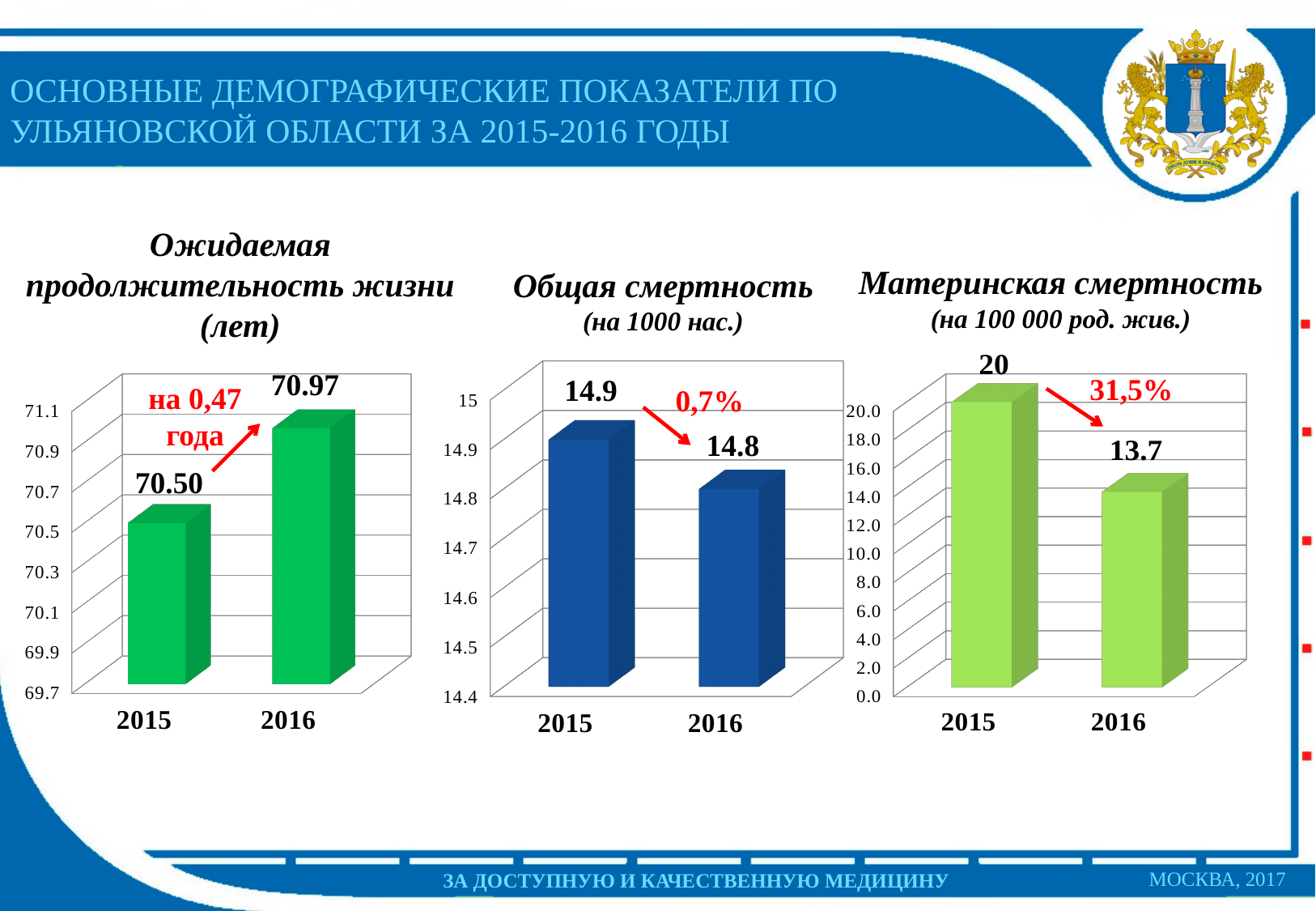
In the 'Материнская смертность' chart, what is the value for 2016? 13.7 In the 'Ожидаемая продолжительность жизни (лет)' chart, what is the value for 2015? 70.50 In the 'Ожидаемая продолжительность жизни (лет)' chart, what is the value for 2016? 70.97 In the 'Ожидаемая продолжительность жизни (лет)' chart, which year has the larger value, 2015 or 2016? 2016 In the 'Общая смертность' chart, what is the value for 2015? 14.9 In the 'Материнская смертность' chart, is the value for 2016 greater or less than 14.0? less In the 'Общая смертность' chart, do the values rise or fall from 2015 to 2016? fall How many categories are shown on the x axis of the 'Общая смертность' chart? 2 What kind of chart is the 'Материнская смертность' chart? bar chart In the 'Материнская смертность' chart, which year has the highest value? 2015 In the 'Материнская смертность' chart, what is the difference between the 2015 and 2016 values? 6.3 In the 'Общая смертность' chart, which year has the lowest value? 2016